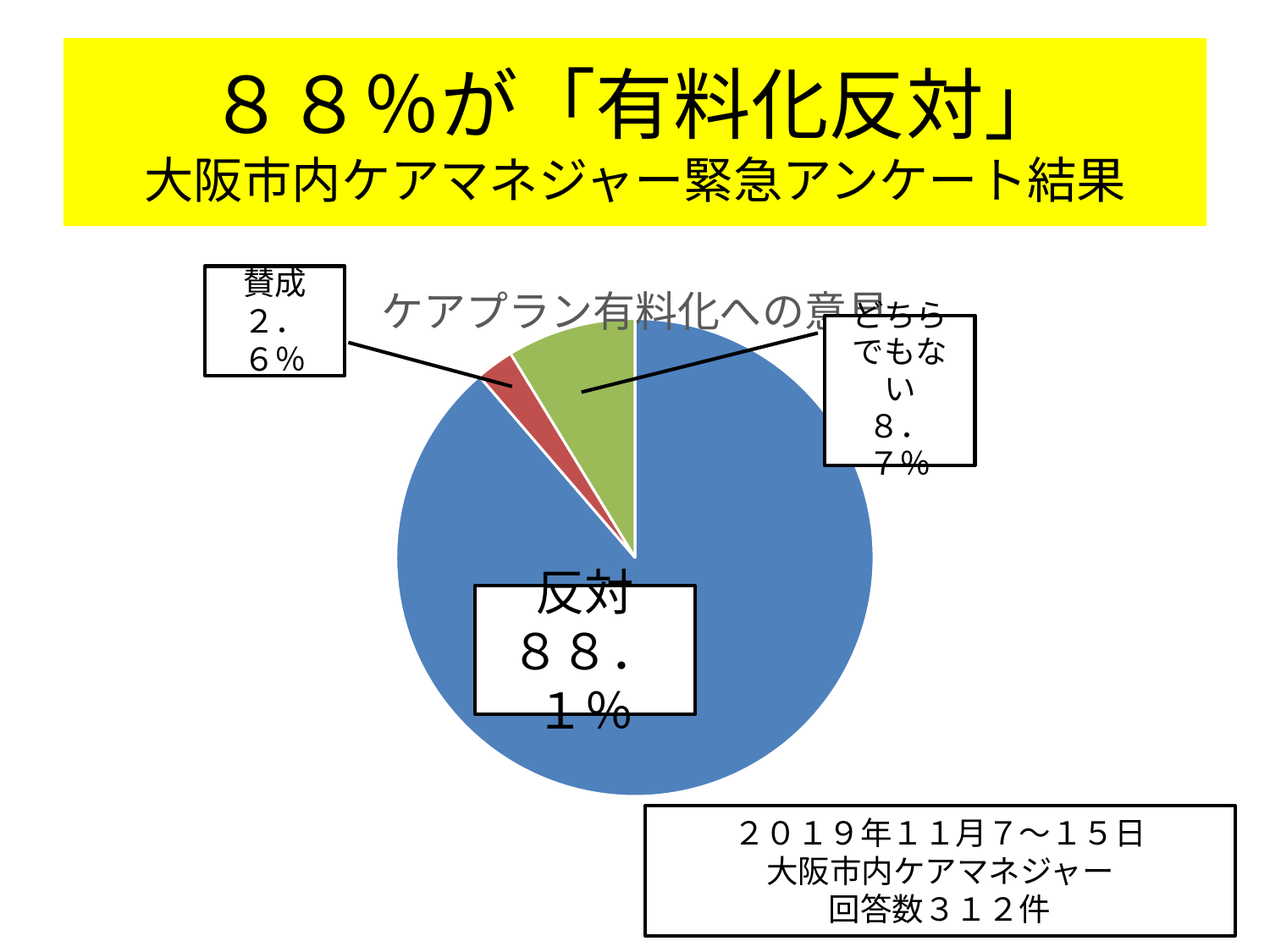
What percentage of respondents answered 賛成? ２．６％ What is the title of the pie chart? ケアプラン有料化への意見 How many slices does the pie chart have? 3 What colour is the 反対 slice? blue Which response has the largest share of the pie? 反対 Which response has the smallest share of the pie? 賛成 What percentage of respondents answered 反対? ８８．１％ What kind of chart is shown on the slide? pie chart How many percentage points larger is どちらでもない than 賛成? 6.1 Which is larger, the share for どちらでもない or the share for 賛成? どちらでもない What percentage of respondents answered どちらでもない? ８．７％ How many percentage points larger is 反対 than どちらでもない? 79.4